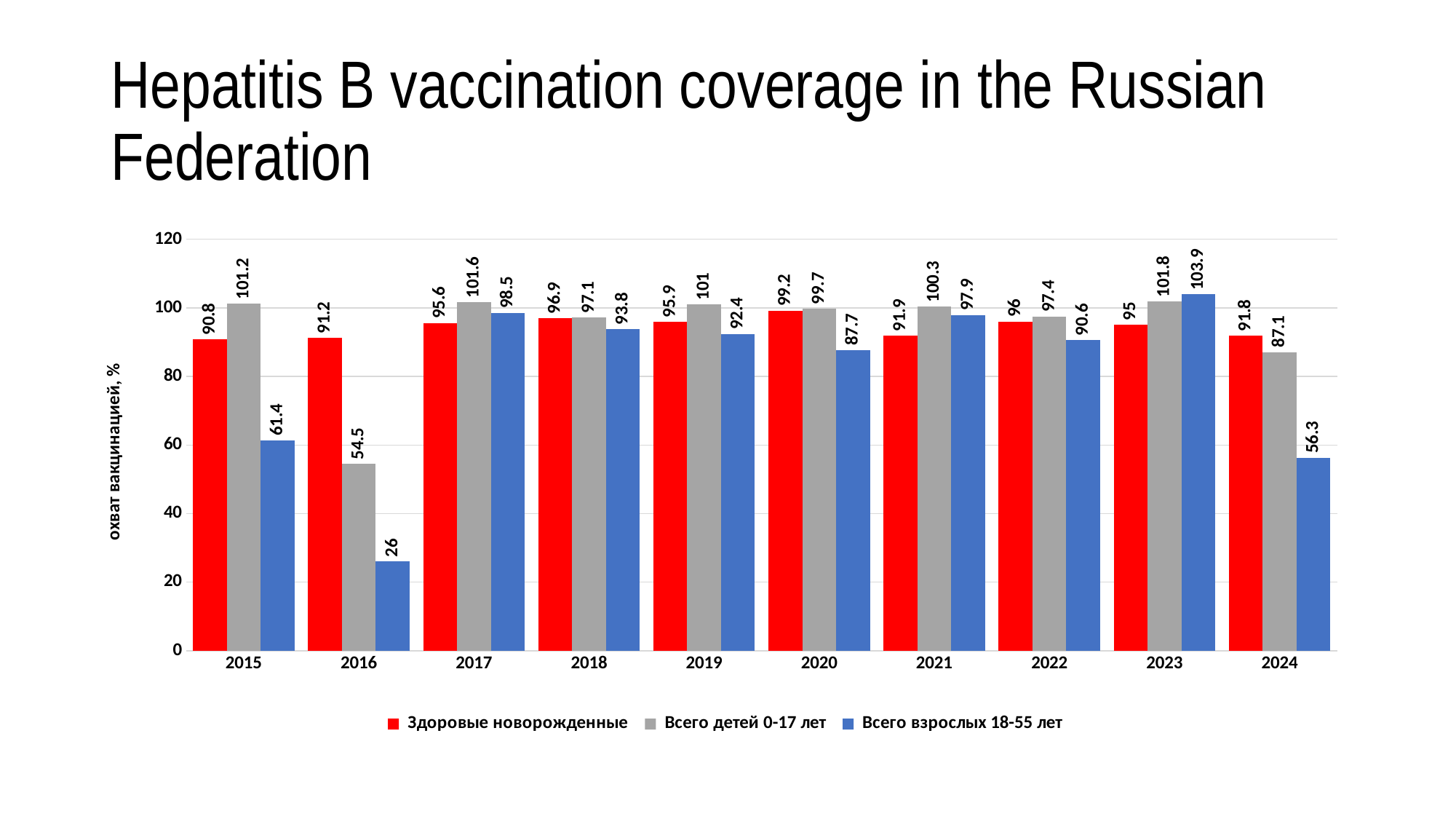
What is the value for Здоровые новорожденные in 2020? 99.2 What is the value for Всего взрослых 18-55 лет in 2016? 26 What is the label of the y axis? охват вакцинацией, % How many series does the legend list? 3 In which year is the value for Всего взрослых 18-55 лет highest? 2023 What is the value for Всего детей 0-17 лет in 2024? 87.1 Is the value for Всего взрослых 18-55 лет in 2024 greater or less than 60? less What is the difference between the Всего детей 0-17 лет value and the Всего взрослых 18-55 лет value in 2015? 39.8 How many years are shown on the x axis? 10 Which is larger in 2024: the value for Здоровые новорожденные or the value for Всего взрослых 18-55 лет? Здоровые новорожденные In which year is the value for Всего взрослых 18-55 лет lowest? 2016 What kind of chart is shown on the slide? bar chart